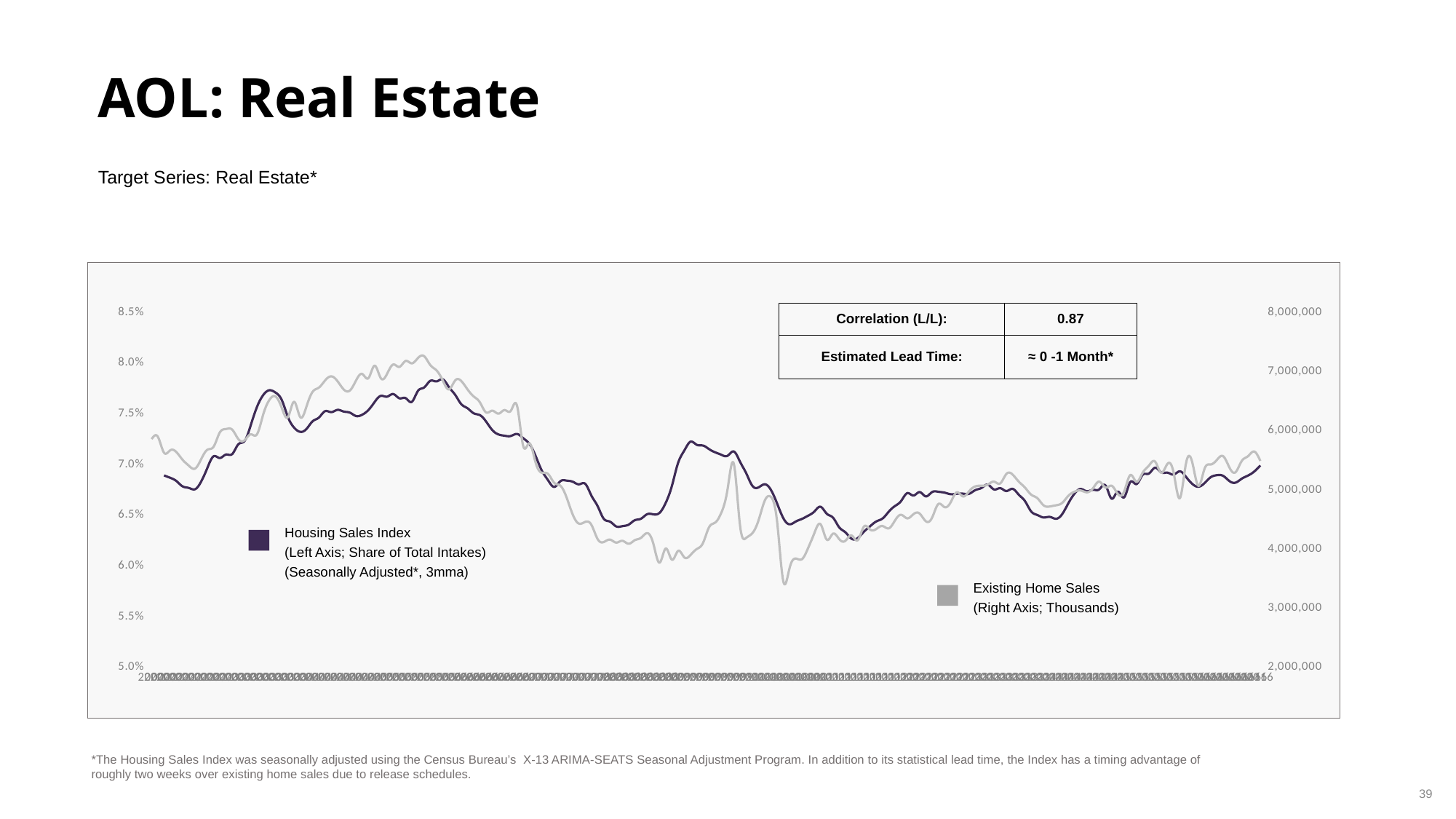
Is the highest value reached by the Housing Sales Index greater or less than 7.5%? greater Is the highest value reached by Existing Home Sales greater or less than 7,000,000? greater Which series is plotted against the left axis? Housing Sales Index How many series does the chart's legend list? 2 Is the lowest value reached by the Housing Sales Index greater or less than 6.5%? less What is the minimum value shown on the right axis of the chart? 2,000,000 What is the Estimated Lead Time shown in the table on the chart? ≈ 0 -1 Month* What kind of chart is shown on the slide? Line chart What is the Correlation (L/L) value shown in the table on the chart? 0.87 What is the maximum value shown on the left axis of the chart? 8.5% Which series is plotted against the right axis? Existing Home Sales